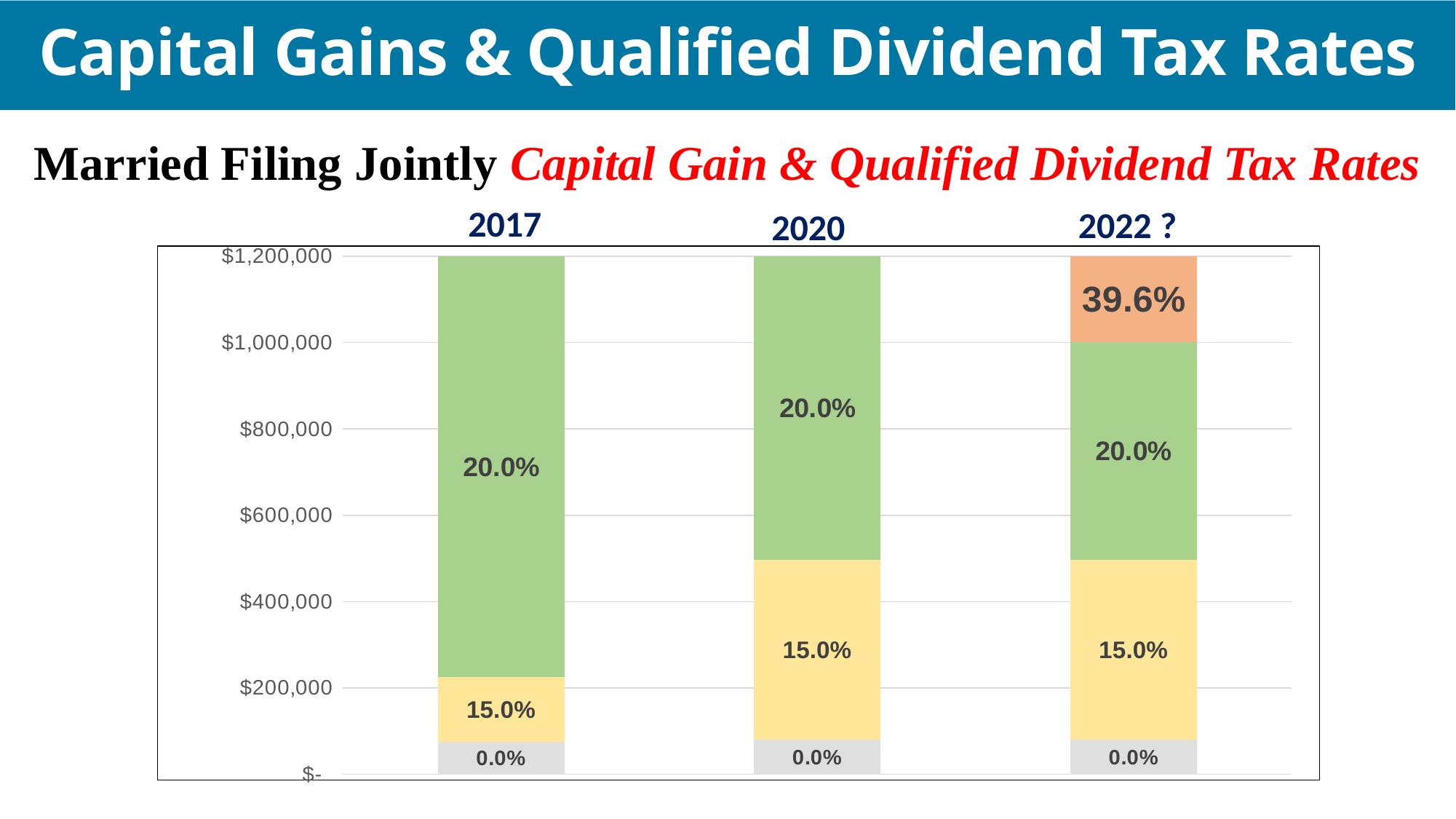
Is the top of the 15.0% segment in the 2017 bar greater or less than $400,000? less What tax rate is labelled on the green segment of the 2017 bar? 20.0% At what income level on the y axis does the 39.6% segment of the 2022 ? bar begin? $1,000,000 What kind of chart is shown on the slide? Stacked bar chart What tax rate is labelled on the yellow segment of the 2020 bar? 15.0% How many bars (years) are shown in the chart? 3 What tax rate is labelled on the lowest (grey) segment of each bar? 0.0% Is the top of the 15.0% segment in the 2020 bar greater or less than $400,000? greater What tax rate is labelled on the top (orange) segment of the 2022 ? bar? 39.6% How many rate segments does the 2017 bar have? 3 What are the three year labels above the bars? 2017, 2020, 2022 ? How many rate segments does the 2022 ? bar have? 4